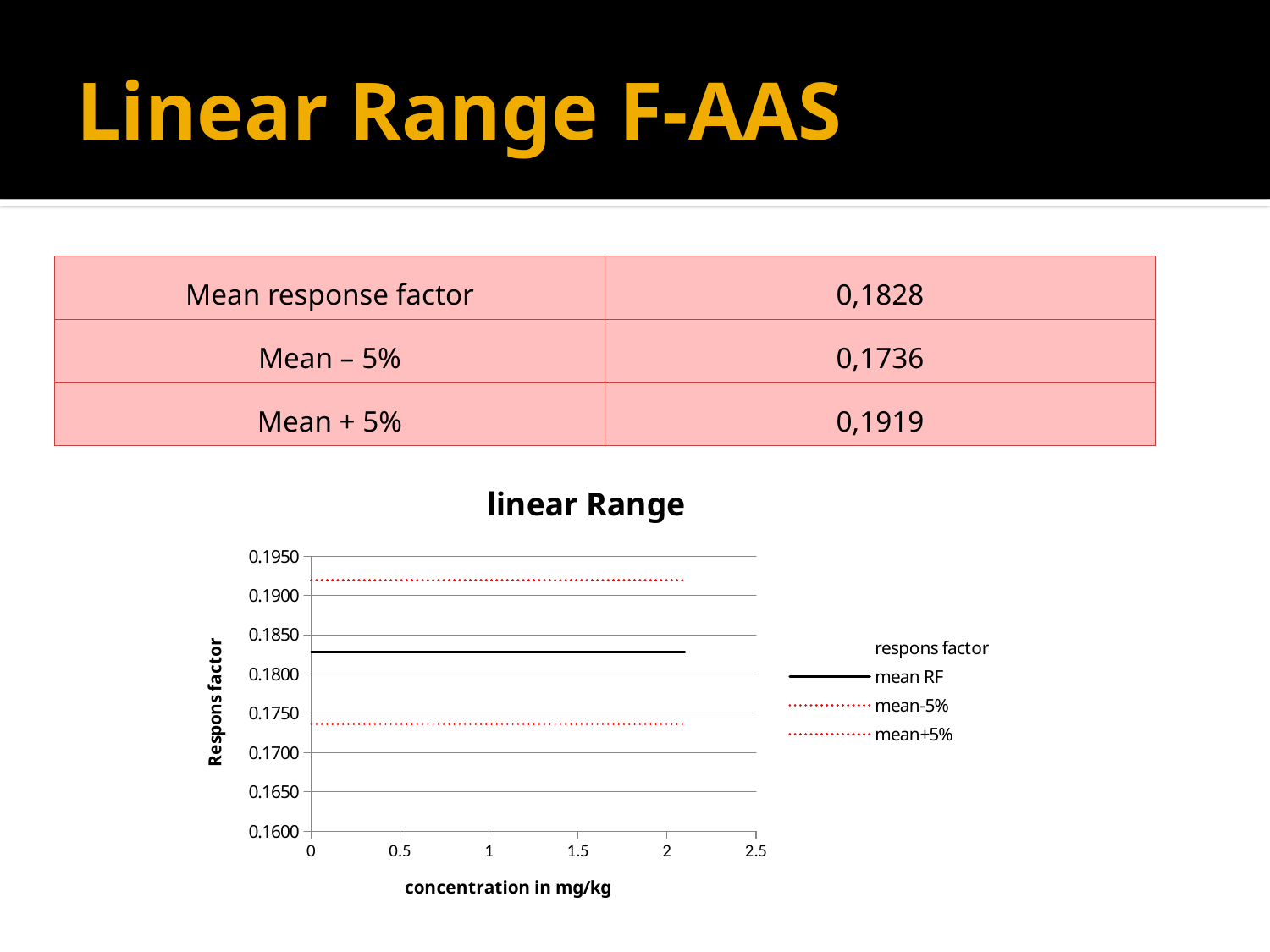
What kind of chart is the "linear Range" chart? line chart In the "linear Range" chart, which plotted line has the highest value? mean+5% What is the x-axis label of the "linear Range" chart? concentration in mg/kg How many series does the legend of the "linear Range" chart list? 4 In the "linear Range" chart, is the value of the mean+5% line greater or less than 0.1900? greater In the "linear Range" chart, is the value of the mean RF line greater or less than 0.1800? greater In the "linear Range" chart, is the value of the mean-5% line greater or less than 0.1750? less What is the title of the chart on the slide? linear Range In the "linear Range" chart, which plotted line has the lowest value? mean-5% In the "linear Range" chart, does the mean RF line rise, fall or stay flat as concentration increases? stays flat In the "linear Range" chart, which line is higher, mean+5% or mean-5%? mean+5%